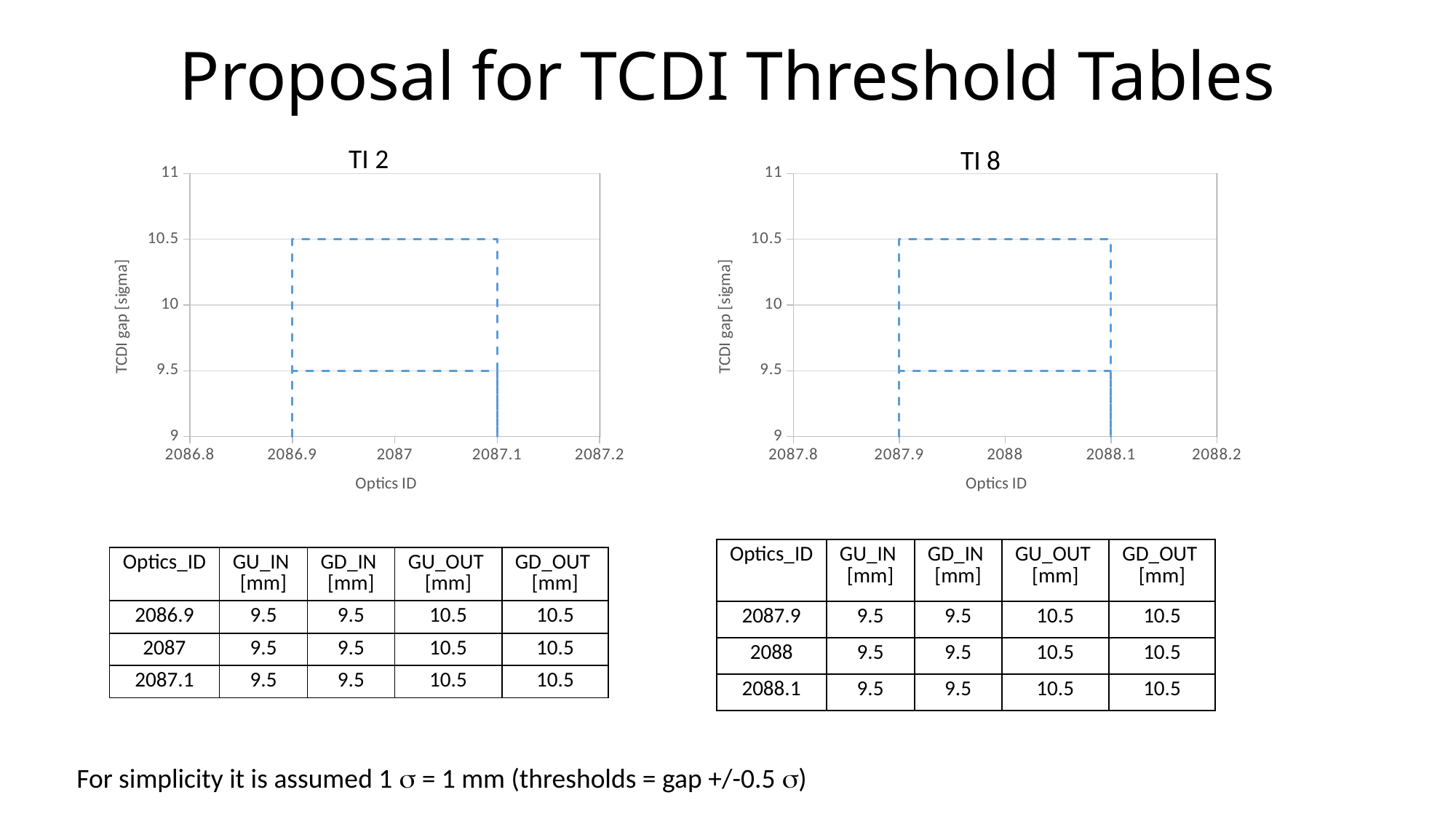
What is the title of the chart on the right? TI 8 In the TI 2 chart, what kind of chart is shown? line chart In the TI 2 chart, at which Optics ID does the dashed rectangle end on the right? 2087.1 What is the title of the chart on the left? TI 2 In the TI 2 chart, what is the lower TCDI gap value of the dashed rectangle? 9.5 In the TI 2 chart, is the lower threshold value greater or less than 10? less In the TI 8 chart, at which Optics ID does the dashed rectangle start on the left? 2087.9 In the TI 2 chart, what is the upper TCDI gap value of the dashed rectangle? 10.5 In the TI 8 chart, is the upper threshold value greater or less than 10? greater In the TI 8 chart, what is the upper TCDI gap value of the dashed rectangle? 10.5 In the TI 8 chart, what is the lower TCDI gap value of the dashed rectangle? 9.5 In the TI 2 chart, what is the difference between the upper and lower TCDI gap thresholds? 1